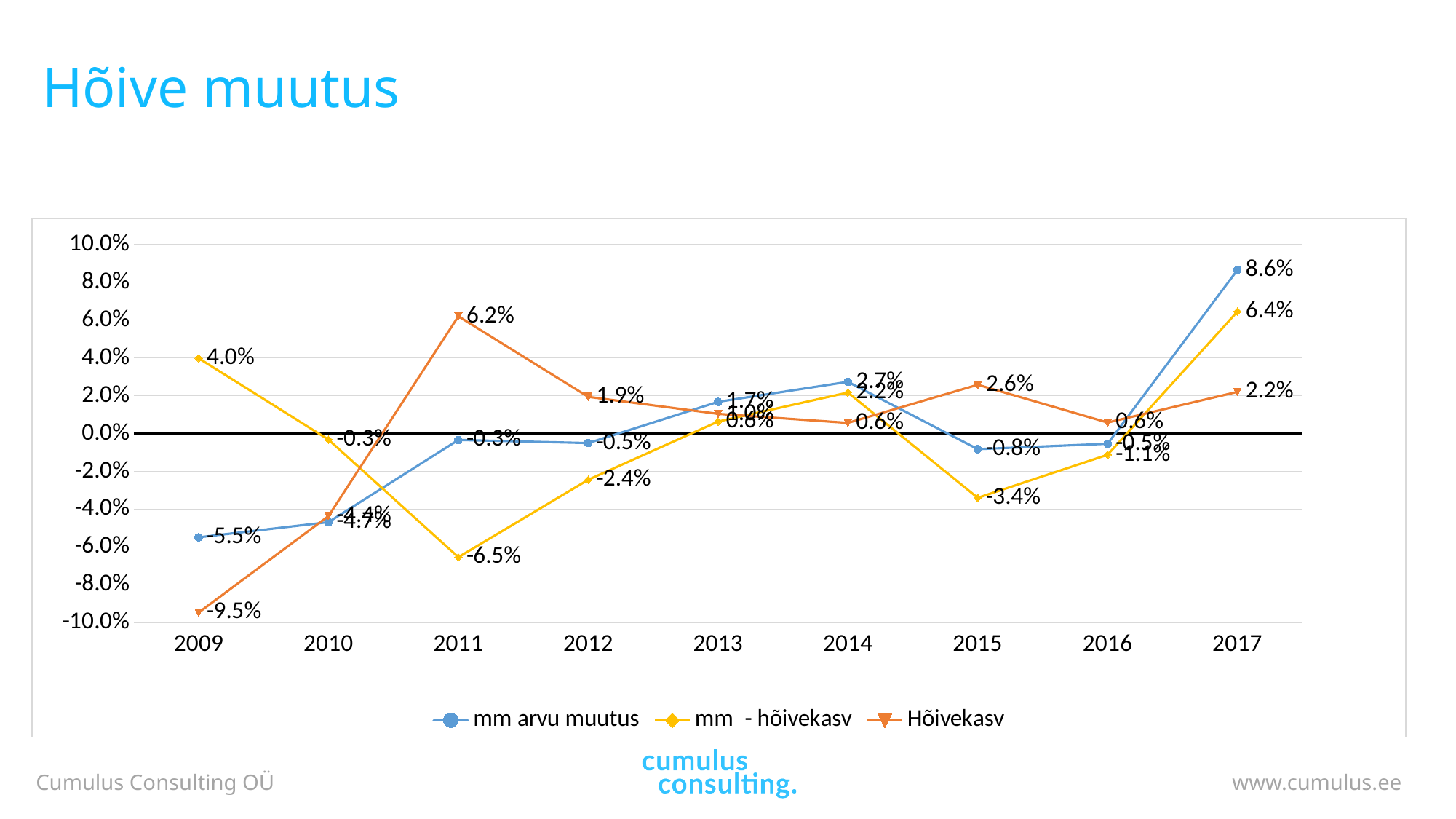
What is the value of mm - hõivekasv in 2011? -6.5% How many series does the legend list? 3 In which year does Hõivekasv reach its highest value? 2011 What is the value of Hõivekasv in 2009? -9.5% What is the difference between mm arvu muutus and mm - hõivekasv in 2017? 2.2 percentage points What kind of chart is shown on the slide? line chart In which year does mm - hõivekasv reach its lowest value? 2011 How many years are plotted along the x axis? 9 In 2015, which is larger: Hõivekasv or mm - hõivekasv? Hõivekasv What is the title of the chart on the slide? Hõive muutus What is the value of mm arvu muutus in 2017? 8.6% Is the value for mm arvu muutus in 2009 greater or less than -4.0%? less